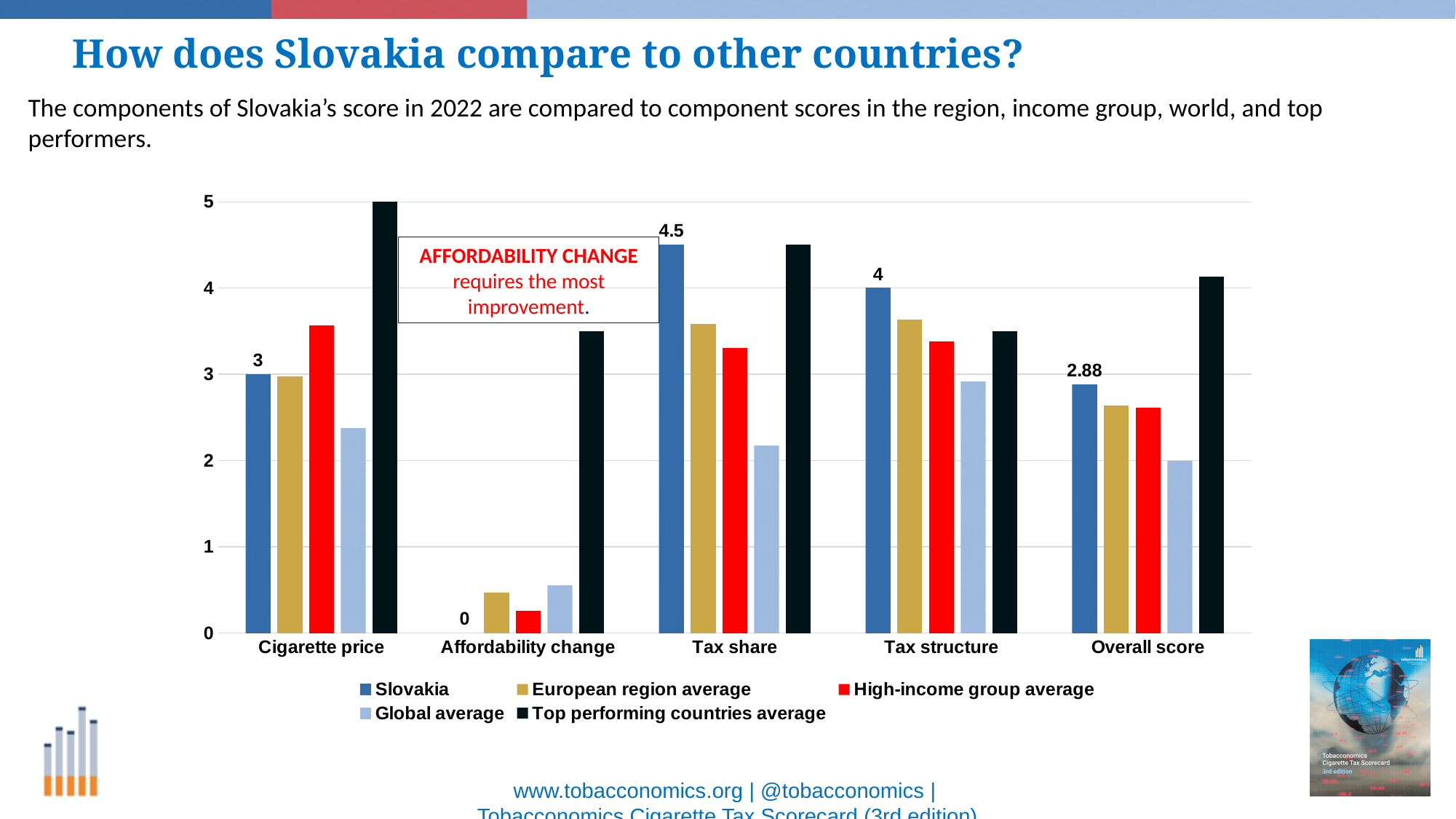
Which is larger for Tax structure: the Slovakia bar or the Global average bar? Slovakia Is the Global average for Tax share greater or less than 3? less What is Slovakia's Overall score? 2.88 What is the difference between Slovakia's Tax share score and its Cigarette price score? 1.5 Among the Slovakia bars, which category has the highest value? Tax share What is Slovakia's score for Cigarette price? 3 What kind of chart is shown on the slide? Bar chart What is Slovakia's score for Tax share? 4.5 How many series does the legend list? 5 Is the Top performing countries average for Affordability change greater or less than 3? greater Among the Slovakia bars, which category has the lowest value? Affordability change What is Slovakia's score for Affordability change? 0